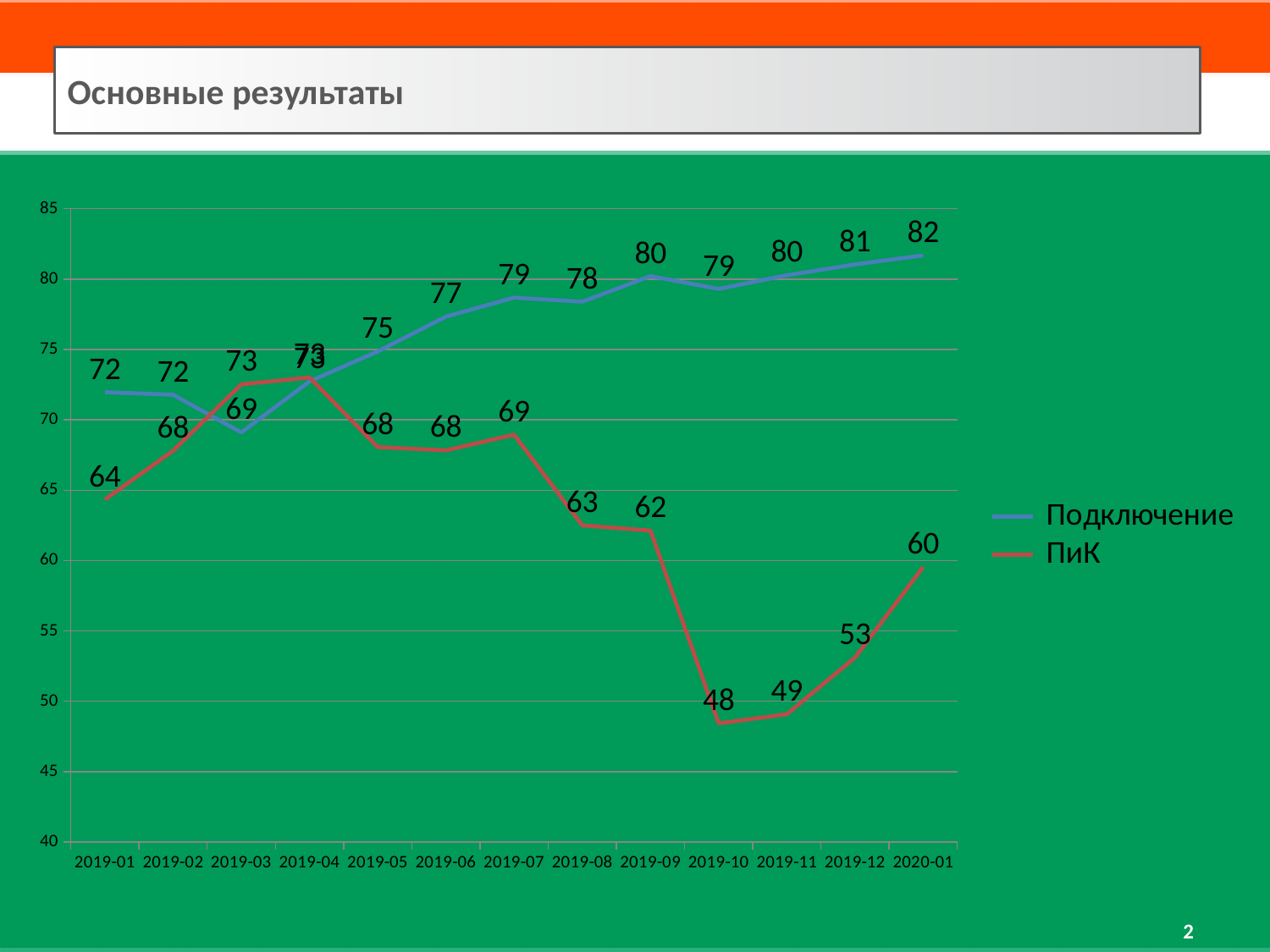
How many time points are plotted along the x axis? 13 What is the value of ПиК for 2019-10? 48 Which series is drawn in red? ПиК What is the difference between Подключение and ПиК in 2019-10? 31 What kind of chart is shown on the slide? line chart What is the value of ПиК for 2019-01? 64 Does the ПиК series rise or fall between 2019-07 and 2019-10? fall Which series has the larger value in 2019-03, Подключение or ПиК? ПиК What is the value of Подключение for 2020-01? 82 In which month does Подключение reach its highest value? 2020-01 In which month does ПиК reach its lowest value? 2019-10 How many series does the legend list? 2